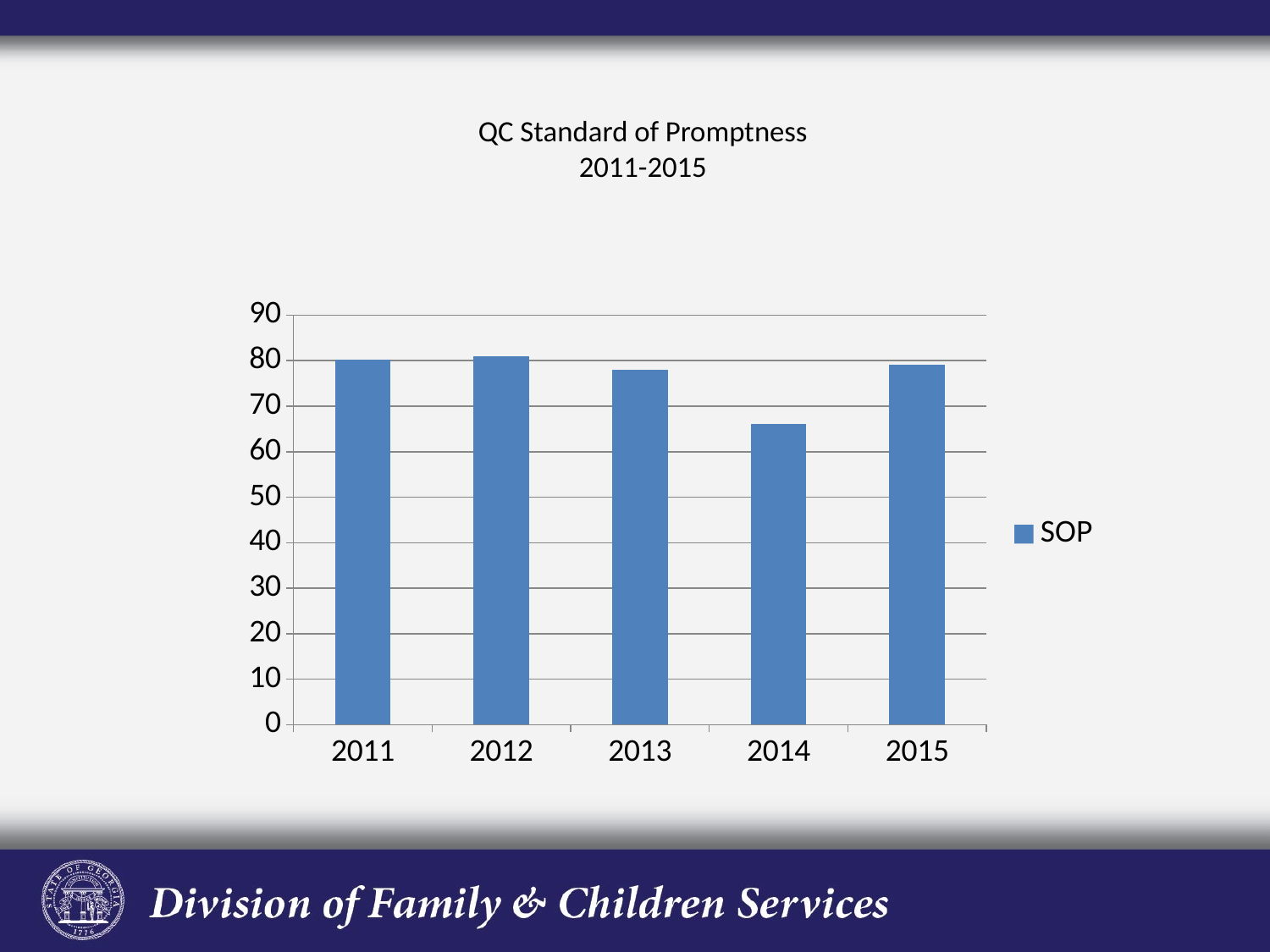
What is the title of the chart? QC Standard of Promptness 2011-2015 How many years are shown on the x axis? 5 How many series does the legend list? 1 Is the SOP value for 2013 greater or less than 70? greater Does the SOP value rise or fall from 2013 to 2014? fall Which year has the larger SOP value, 2011 or 2014? 2011 What kind of chart is shown on the slide? bar chart What series name does the legend show? SOP Is the SOP value for 2014 greater or less than 70? less Which year has the larger SOP value, 2013 or 2014? 2013 Is the SOP value for 2014 greater or less than 60? greater Which year has the lowest SOP value? 2014